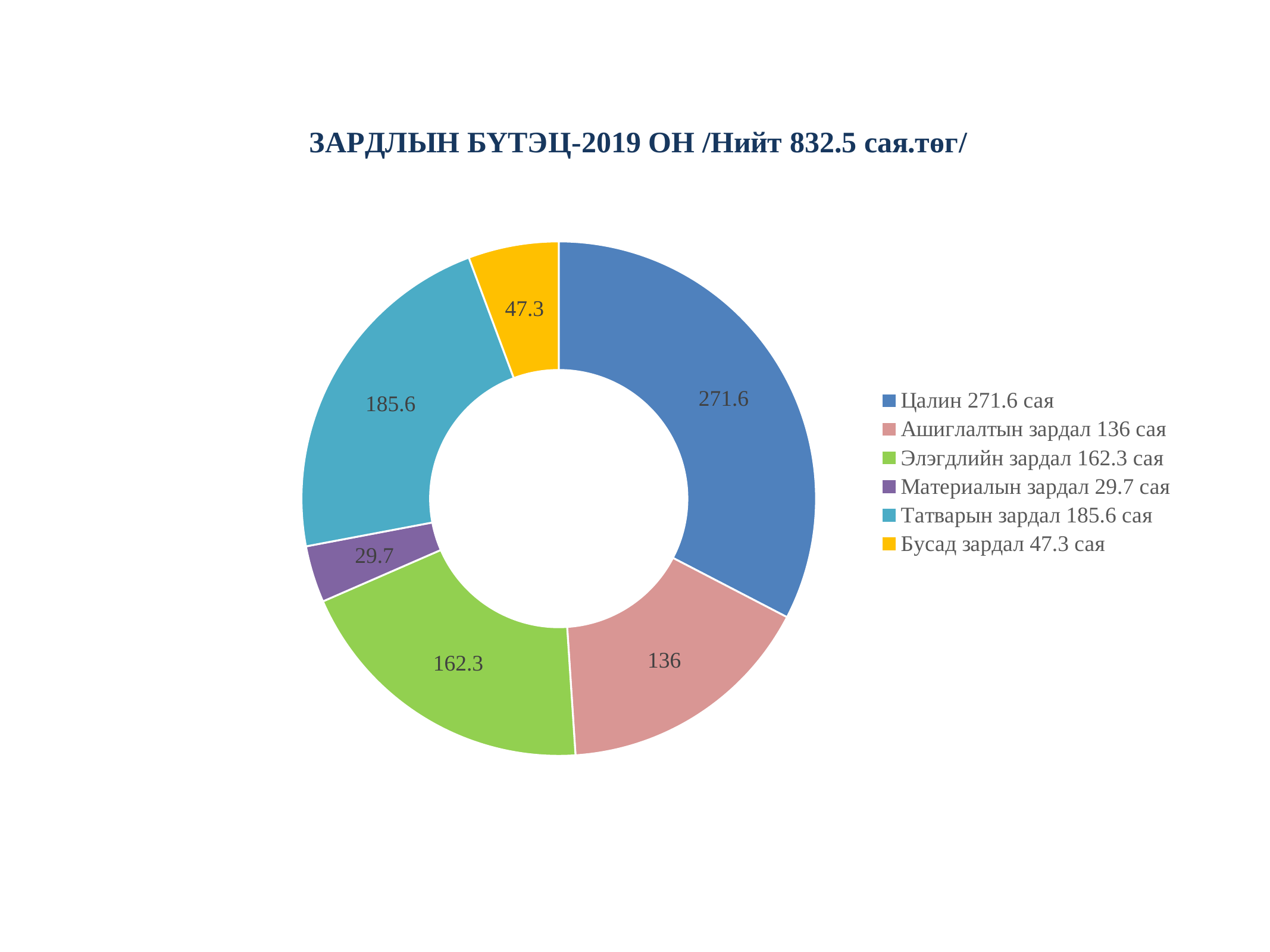
Which category has the largest value? Цалин Which is larger, Элэгдлийн зардал or Ашиглалтын зардал? Элэгдлийн зардал What is the difference between the values for Цалин and Ашиглалтын зардал? 135.6 What is the difference between the values for Татварын зардал and Элэгдлийн зардал? 23.3 What kind of chart is shown on the slide? Doughnut chart What colour is the slice for Бусад зардал? Yellow How many categories are shown in the chart? 6 What is the value for Материалын зардал? 29.7 What is the value for Цалин? 271.6 What is the total shown in the chart title? 832.5 сая.төг Which category has the smallest value? Материалын зардал What is the value for Татварын зардал? 185.6